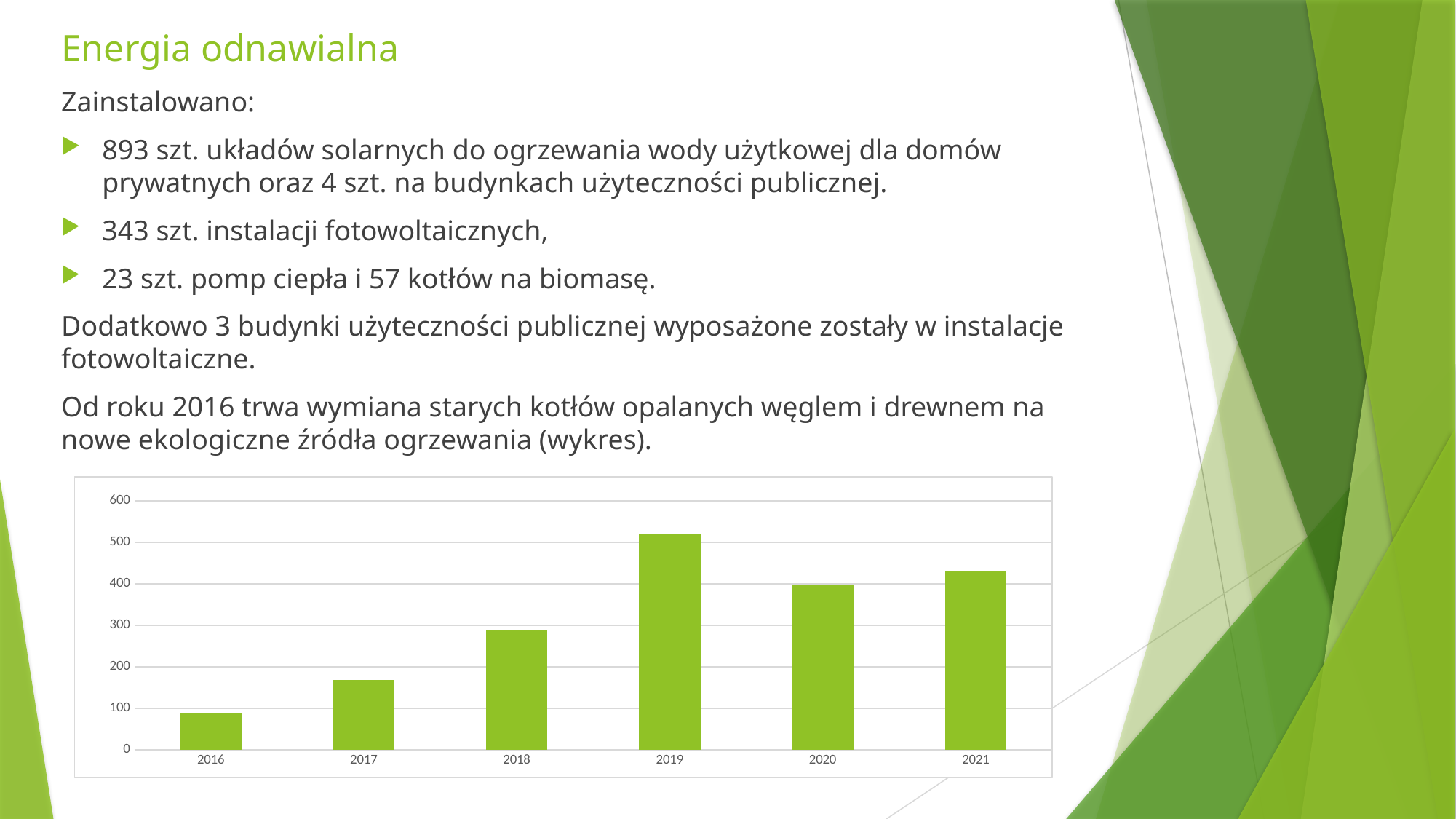
Is the value for 2021 greater or less than 500? less Is the value for 2017 greater or less than 200? less Is the value for 2019 greater or less than 500? greater Which year has the larger value, 2019 or 2021? 2019 Which year has the larger value, 2017 or 2018? 2018 Which year has the lowest bar in the chart? 2016 What colour are the bars in the chart? green What kind of chart is shown on the slide? bar chart Do the values rise or fall from 2016 to 2019? rise Which year has the highest bar in the chart? 2019 How many years are shown on the x axis of the chart? 6